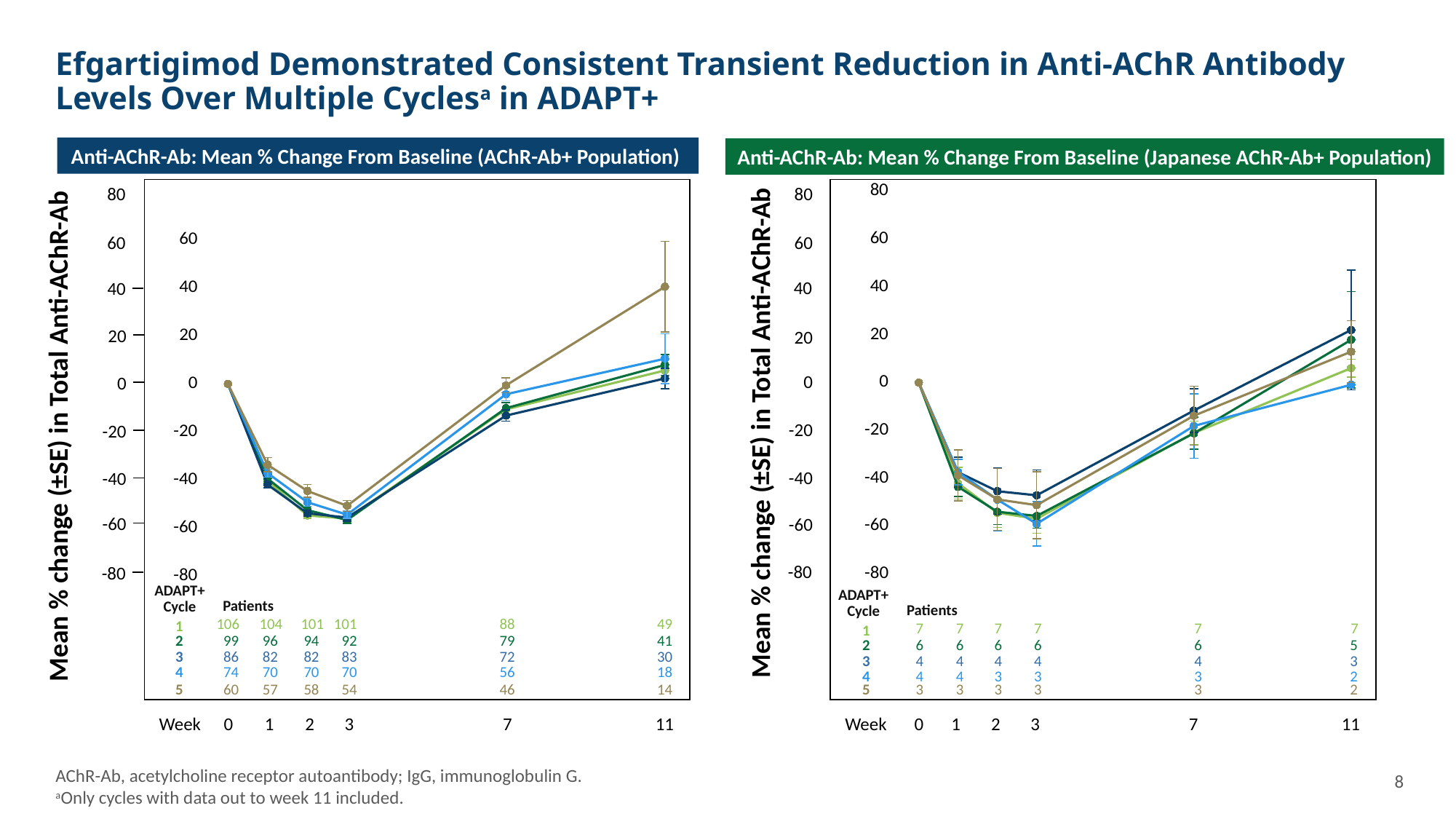
In the left chart (AChR-Ab+ Population), how many patients were in cycle 5 at week 11? 14 In the left chart (AChR-Ab+ Population), do the values rise or fall from week 3 to week 11? rise In the left chart (AChR-Ab+ Population), is the value for cycle 5 at week 3 greater or less than -40? less In the left chart (AChR-Ab+ Population), how many patients were in cycle 1 at week 0? 106 In the left chart (AChR-Ab+ Population), what is the difference in the number of cycle 1 patients between week 0 and week 11? 57 In the left chart (AChR-Ab+ Population), which cycle has the highest mean % change at week 11? Cycle 5 In the right chart (Japanese AChR-Ab+ Population), is the value for cycle 3 at week 11 greater or less than 0? greater In the left chart (AChR-Ab+ Population), is the value for cycle 5 at week 11 greater or less than 20? greater In the left chart (AChR-Ab+ Population), how many ADAPT+ cycles are plotted? 5 In the right chart (Japanese AChR-Ab+ Population), how many patients were in cycle 1 at week 0? 7 In the right chart (Japanese AChR-Ab+ Population), how many week time points are shown on the x axis? 6 What kind of chart is the left chart, 'Anti-AChR-Ab: Mean % Change From Baseline (AChR-Ab+ Population)'? Line chart